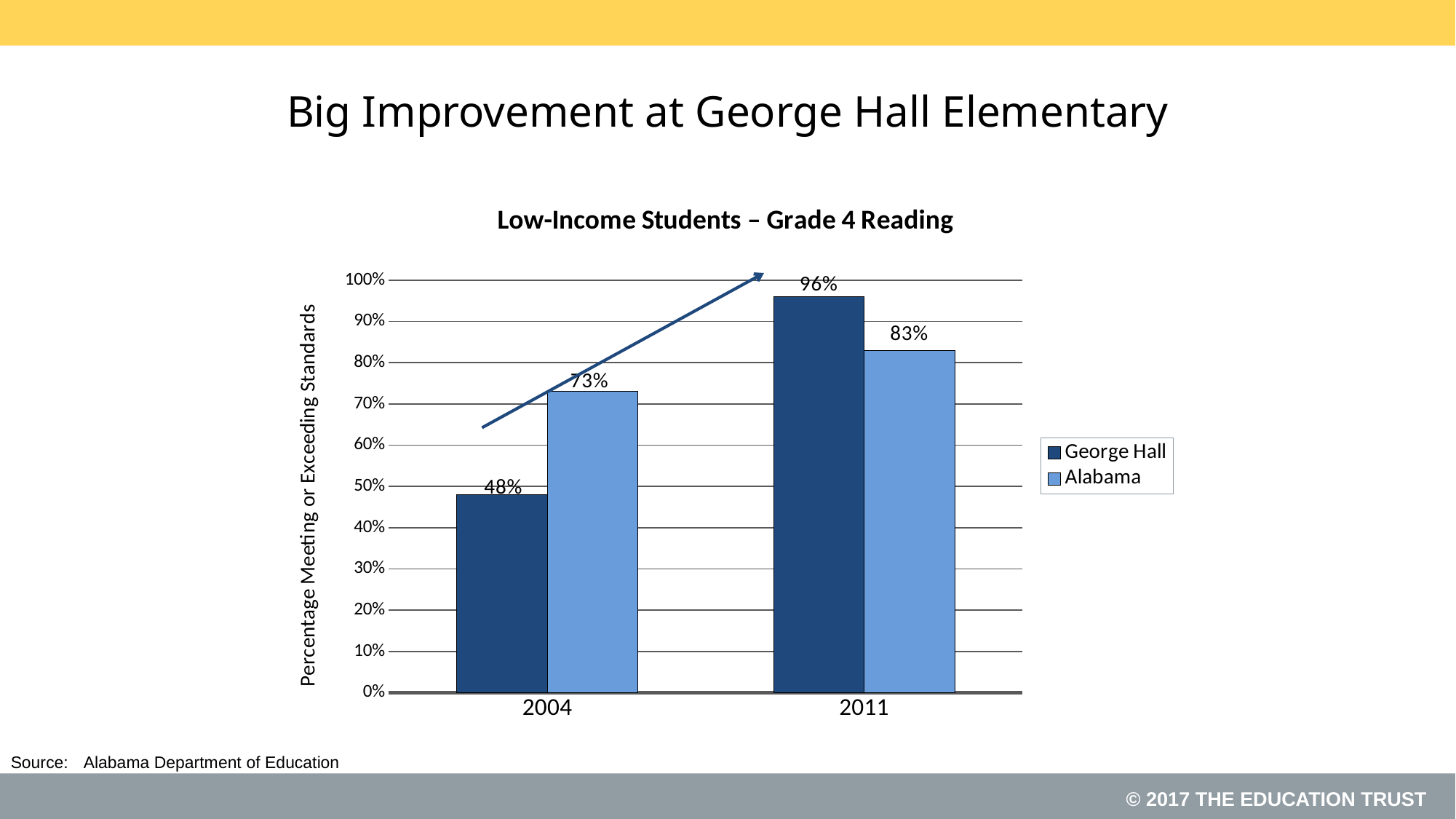
Which bar on the chart is the highest? George Hall in 2011 Which bar on the chart is the lowest? George Hall in 2004 What was the Alabama value for 2011? 83% In 2011, how many percentage points higher was George Hall than Alabama? 13 percentage points What type of chart is shown on the slide? Bar chart What percentage of low-income George Hall students met or exceeded standards in Grade 4 Reading in 2004? 48% What is the title of the chart? Low-Income Students – Grade 4 Reading By how many percentage points did George Hall's value increase from 2004 to 2011? 48 percentage points What was the George Hall value in 2011? 96% What was the Alabama value in 2004? 73% In 2004, which was higher: George Hall or Alabama? Alabama How many series does the legend list? 2